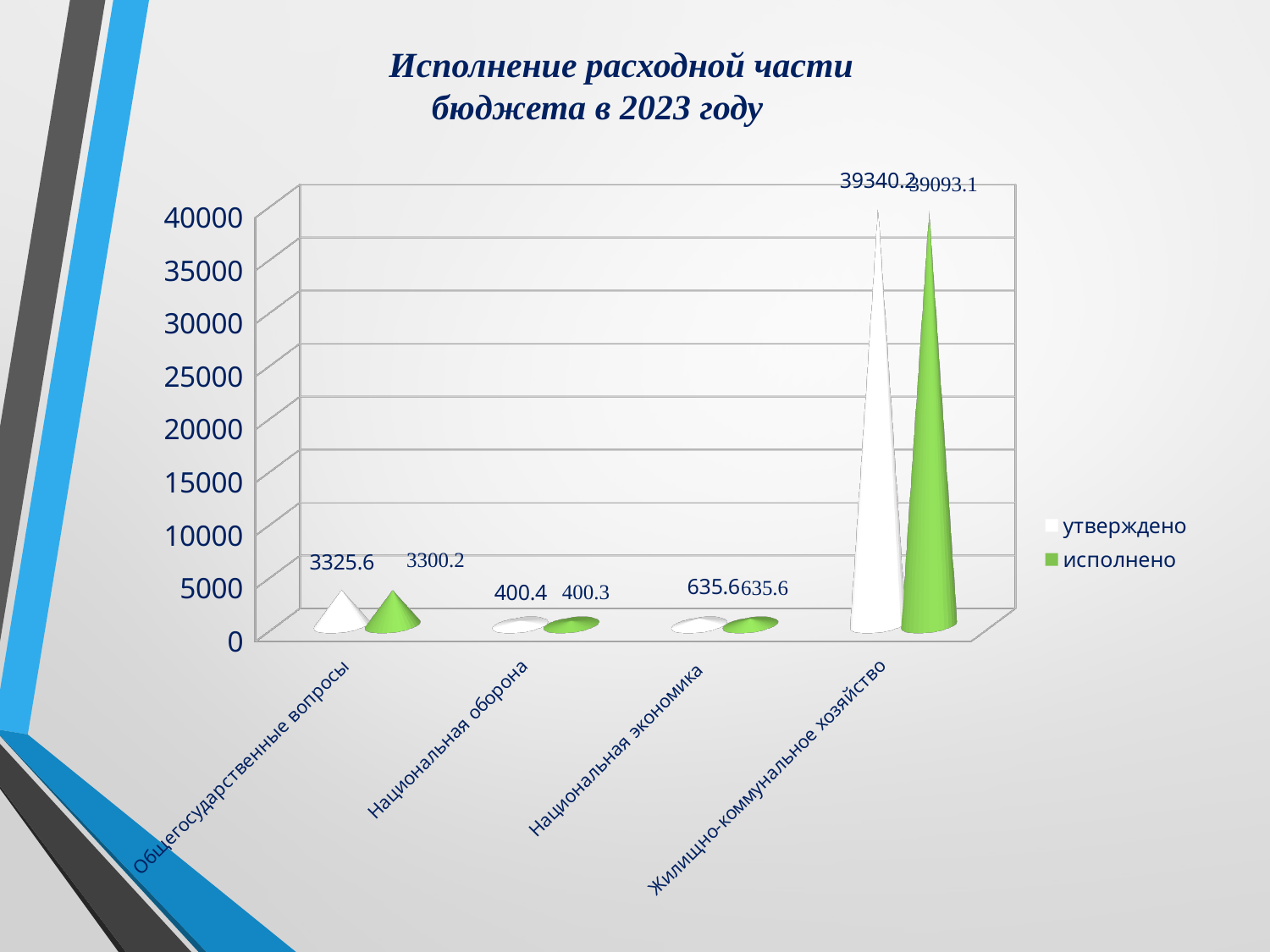
What is the исполнено value for Национальная оборона? 400.3 How many series does the legend list? 2 What is the утверждено value for Общегосударственные вопросы? 3325.6 What kind of chart is shown on the slide? bar chart What is the утверждено value for Национальная экономика? 635.6 How many categories are shown on the x axis? 4 Which is larger for Общегосударственные вопросы: the утверждено value or the исполнено value? утверждено Which category has the lowest исполнено value? Национальная оборона What is the title of the chart? Исполнение расходной части бюджета в 2023 году What is the исполнено value for Жилищно-коммунальное хозяйство? 39093.1 What is the difference between the утверждено and исполнено values for Жилищно-коммунальное хозяйство? 247.1 Which category has the highest утверждено value? Жилищно-коммунальное хозяйство